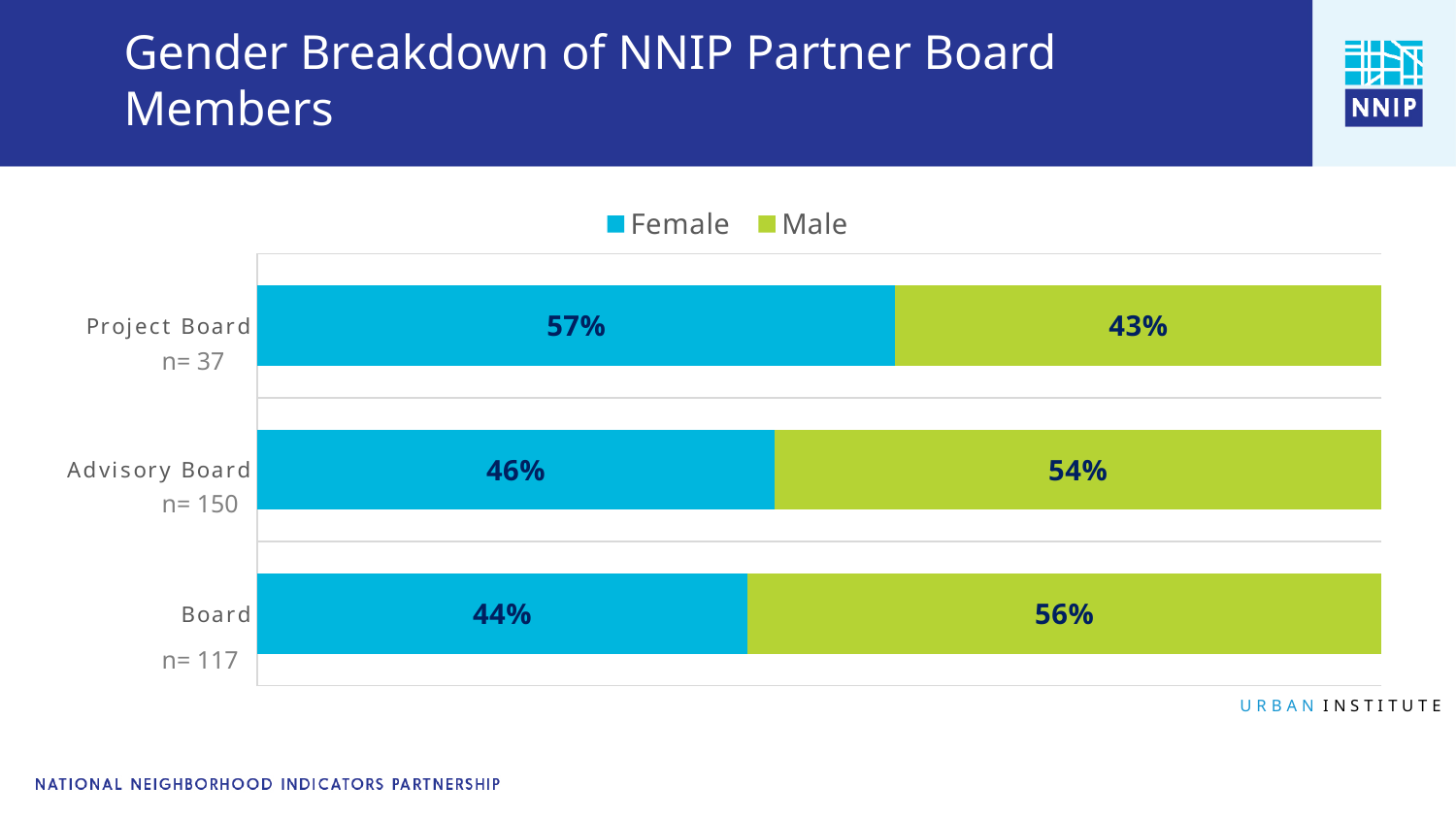
What percentage of Board members are female? 44% How many boards are shown in the chart? 3 On the Advisory Board, is the female share or the male share larger? Male Which board has the highest share of female members? Project Board What is the total of the Project Board bar? 100% What is the sample size (n) for the Advisory Board? 150 Which board has the lowest share of female members? Board What percentage of Project Board members are female? 57% What kind of chart is shown on the slide? Stacked bar chart What percentage of Advisory Board members are male? 54% What is the difference between the male and female shares on the Board (n=117)? 12 percentage points How many series does the legend list? 2